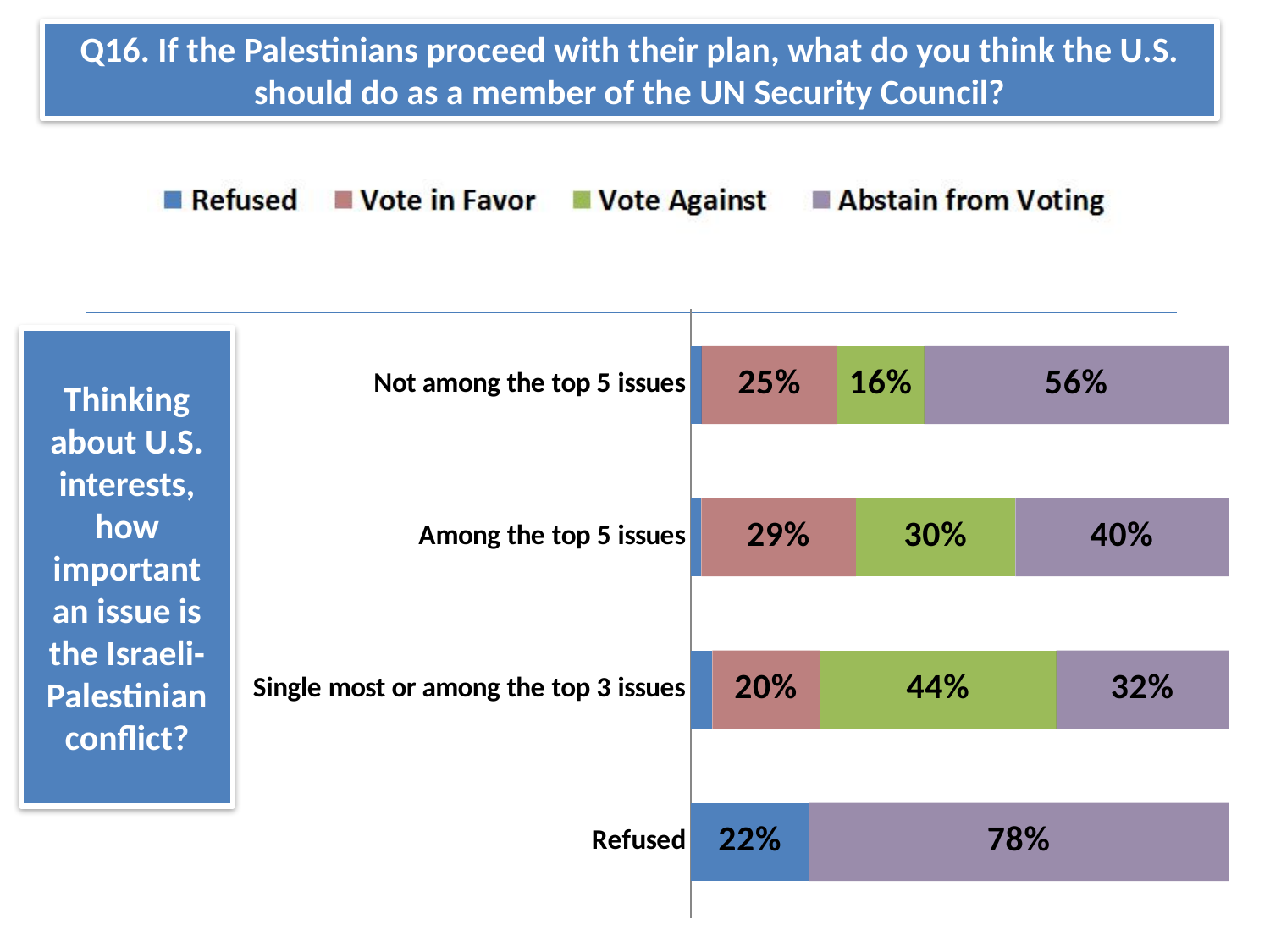
What kind of chart is shown on the slide? Stacked bar chart What is the 'Abstain from Voting' value for the 'Refused' category? 78% How many categories are shown on the chart? 4 What is the 'Vote in Favor' value for the 'Single most or among the top 3 issues' category? 20% Which is larger for the 'Single most or among the top 3 issues' category: 'Vote Against' or 'Abstain from Voting'? Vote Against How many series does the legend list? 4 Which category has the lowest 'Vote Against' value? Not among the top 5 issues What is the difference between the 'Abstain from Voting' values for 'Not among the top 5 issues' and 'Among the top 5 issues'? 16% Which category has the highest 'Vote Against' value? Single most or among the top 3 issues What percentage of respondents who said the conflict is 'Among the top 5 issues' think the U.S. should vote against? 30% What is the 'Abstain from Voting' value for the 'Not among the top 5 issues' category? 56% What is the total of the 'Refused' bar (22% plus 78%)? 100%